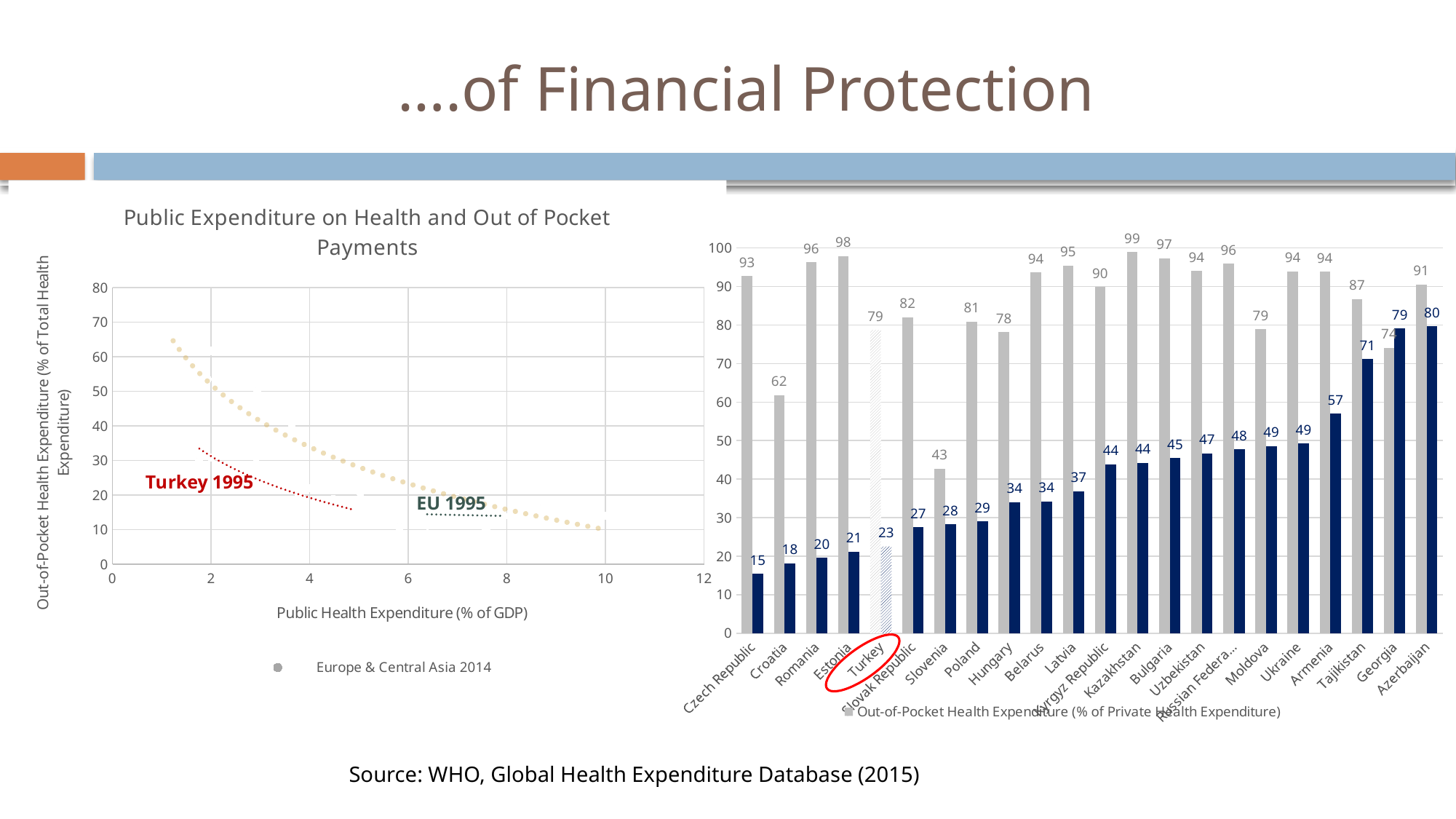
How many countries are shown on the right-hand bar chart? 22 On the right-hand bar chart, which is larger: the gray bar for Croatia or the gray bar for Slovenia? Croatia On the right-hand bar chart, what is the value of the dark blue bar for Turkey? 23 On the right-hand bar chart, what is the difference between the gray bar and the dark blue bar for Turkey? 56 On the right-hand bar chart, which country has the lowest dark blue bar? Czech Republic On the right-hand bar chart, do the dark blue bars generally rise or fall from left to right? Rise What kind of chart is the chart on the right of the slide? Bar chart On the right-hand bar chart, what is the value of the gray bar for Kazakhstan? 99 On the left-hand chart 'Public Expenditure on Health and Out of Pocket Payments', what is the label of the x axis? Public Health Expenditure (% of GDP) On the right-hand bar chart, which country has the lowest gray bar? Slovenia On the right-hand bar chart, which country has the highest dark blue bar? Azerbaijan What kind of chart is 'Public Expenditure on Health and Out of Pocket Payments' on the left of the slide? Scatter chart